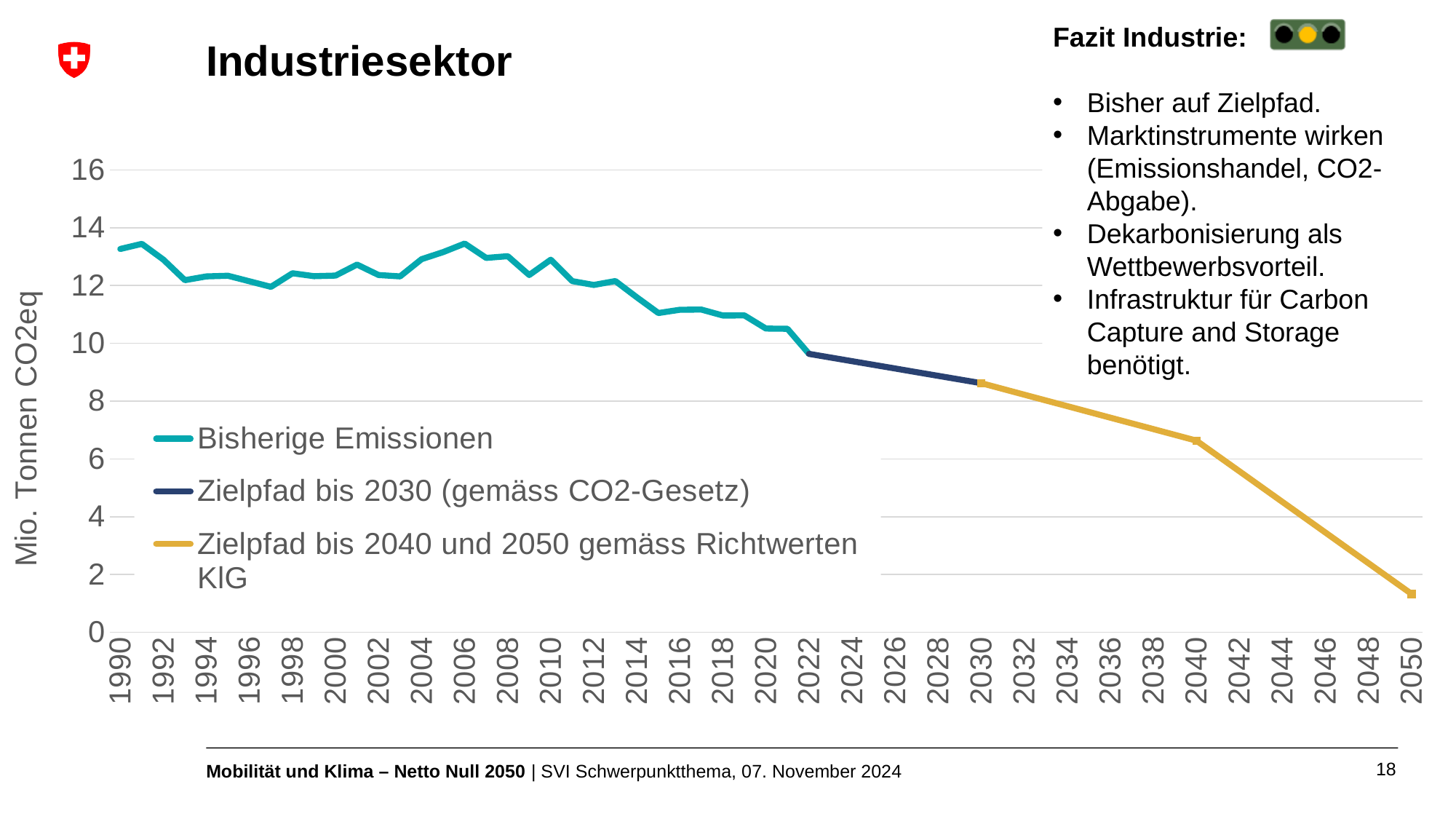
What is the label of the vertical axis of the chart? Mio. Tonnen CO2eq In which year does the chart show its lowest value? 2050 Is the value of Bisherige Emissionen in 1990 greater or less than 12? greater Do the values plotted on the chart generally rise or fall from 1990 to 2050? fall How many series does the chart legend list? 3 What kind of chart is shown on the slide? line chart Is the value of the Zielpfad in 2030 greater or less than 8? greater What is the title of the chart on the slide? Industriesektor Is the value of Bisherige Emissionen in 2022 greater or less than 10? less Which is larger, the value of Bisherige Emissionen in 1990 or in 2022? 1990